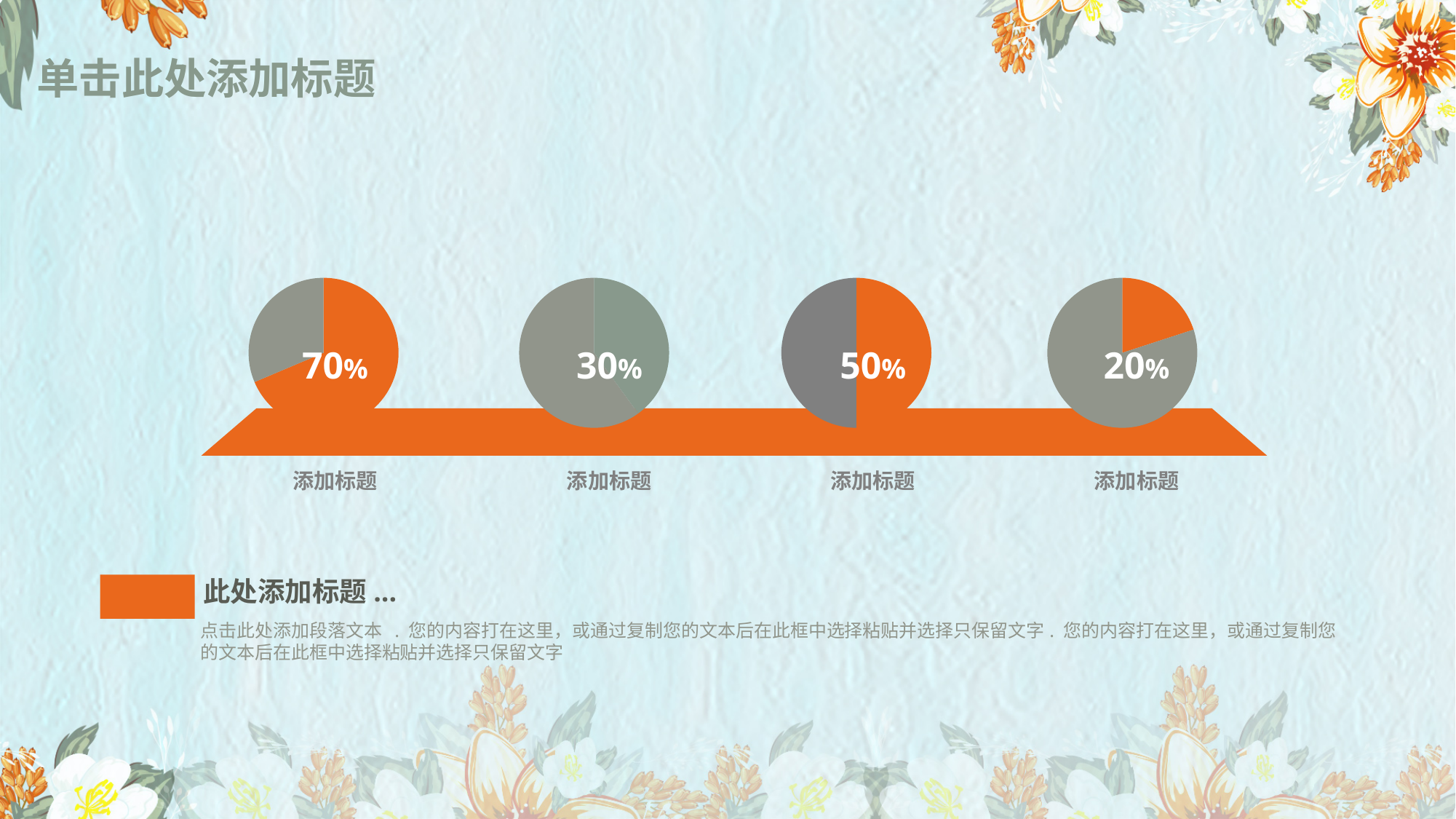
What percentage is printed on the second pie chart from the left? 30% How many pie charts are shown on the slide? 4 What share of the third pie chart from the left does the orange slice take up? 50% Which shows a larger percentage, the leftmost pie chart or the second pie chart from the left? The leftmost pie chart What is the difference between the percentage on the leftmost pie chart and the percentage on the rightmost pie chart? 50 percentage points What colour is the highlighted 70% slice in the leftmost pie chart? Orange What percentage is printed on the leftmost pie chart? 70% What percentage is printed on the third pie chart from the left? 50% Which pie chart shows the lowest percentage? The rightmost pie chart (20%) What kind of charts are shown in the row across the middle of the slide? Pie charts What percentage is printed on the rightmost pie chart? 20% Which pie chart shows the highest percentage? The leftmost pie chart (70%)